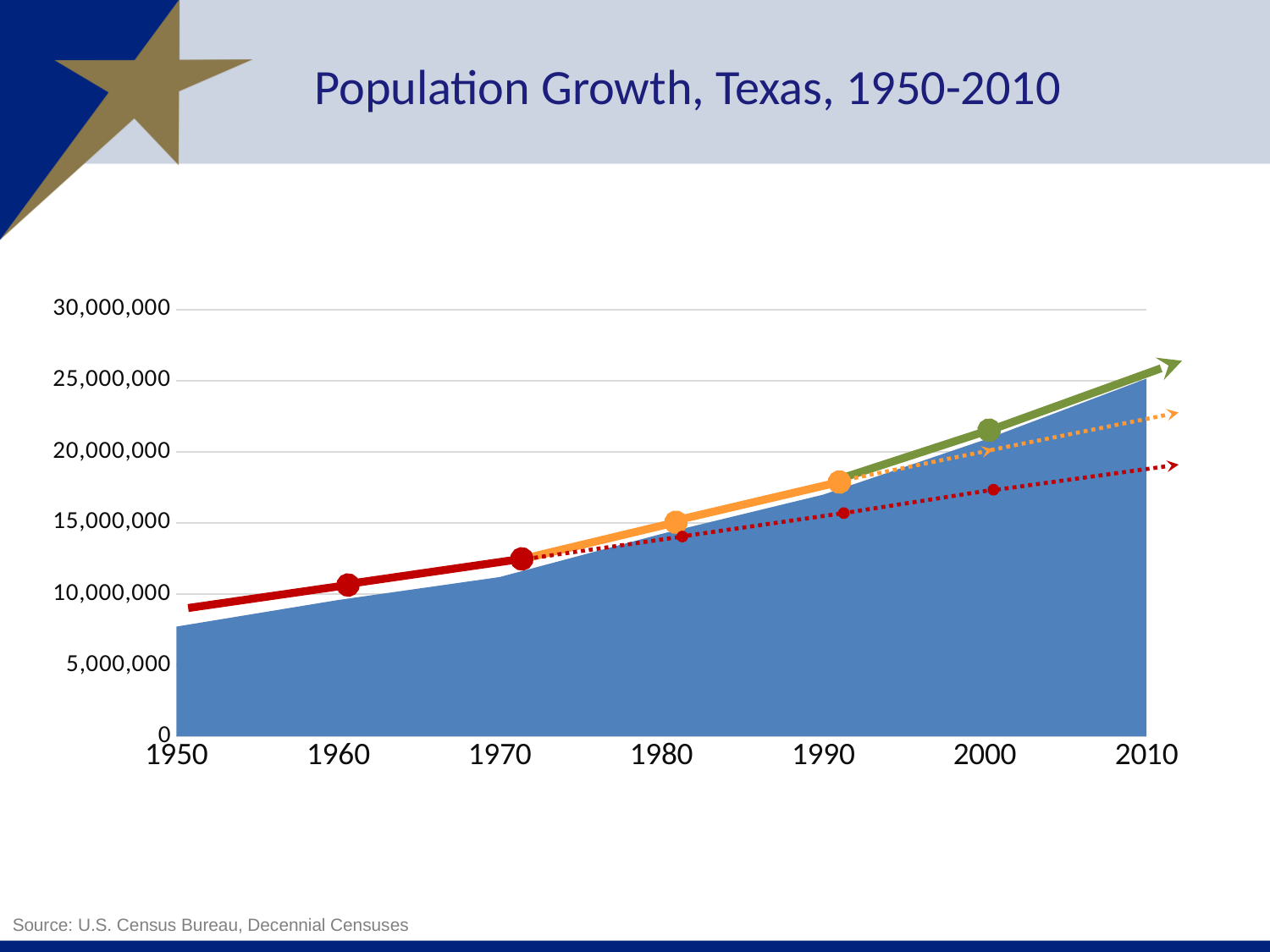
What kind of chart is used to show the population? Area chart What is the title of the chart? Population Growth, Texas, 1950-2010 Does the population rise or fall from 1950 to 2010? Rises How many years are labeled on the x axis? 7 Which year has the larger population, 1980 or 2000? 2000 Which year has the highest population? 2010 Is the population in 1970 greater or less than 15,000,000? less Is the population in 1990 greater or less than 15,000,000? greater Which year has the lowest population? 1950 What is the source cited for the chart data? U.S. Census Bureau, Decennial Censuses Is the population in 2010 greater or less than 20,000,000? greater